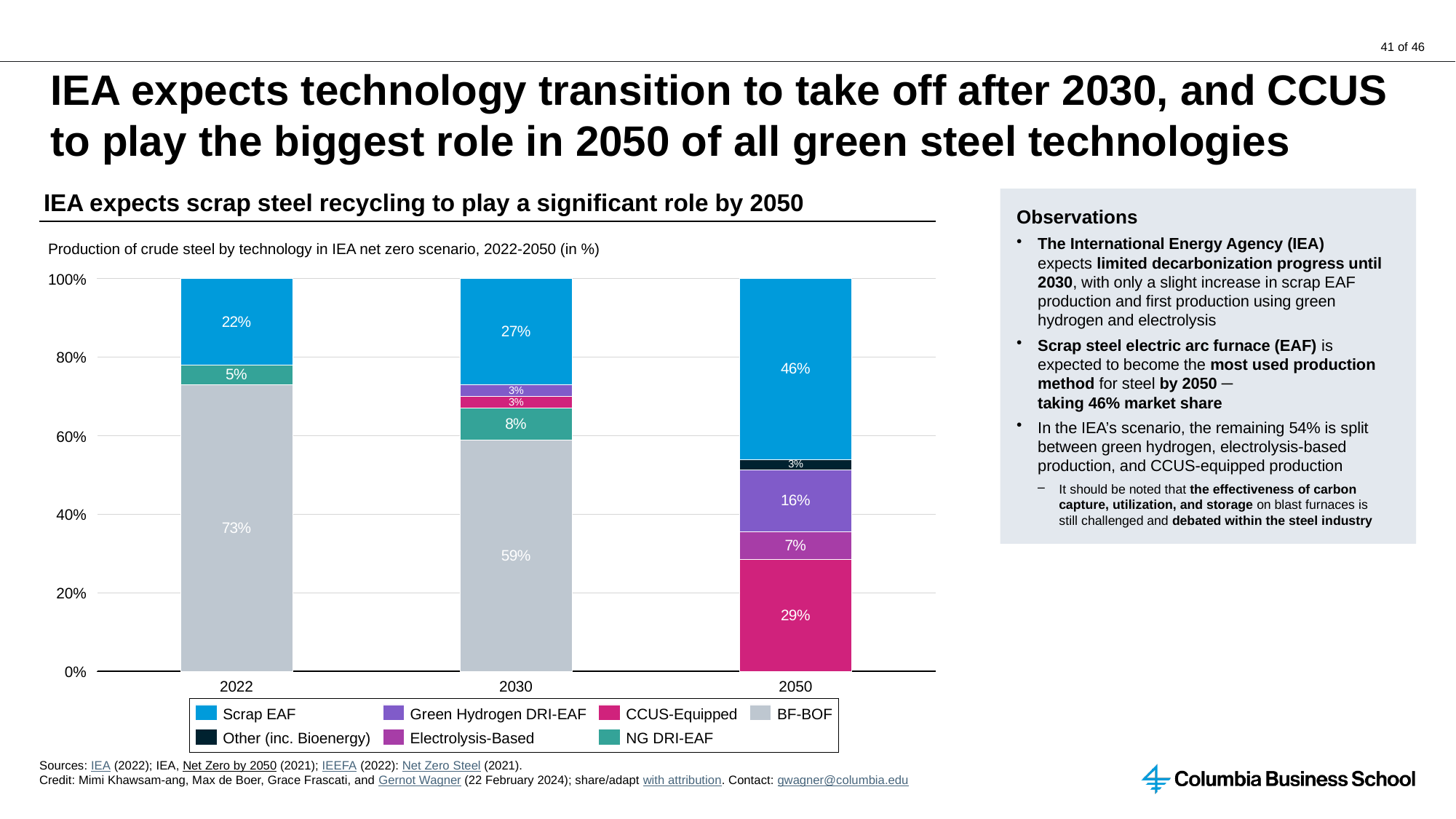
What is the Scrap EAF share in 2050? 46% By how many percentage points does the Scrap EAF share increase from 2022 to 2030? 5 percentage points By how many percentage points does the BF-BOF share fall from 2022 to 2030? 14 percentage points How many technologies does the legend list? 7 What is the NG DRI-EAF share in 2030? 8% What share of crude steel production does BF-BOF account for in 2022? 73% What type of chart is used to show production of crude steel by technology? Stacked bar chart Does the Scrap EAF share rise or fall from 2022 to 2050? Rise What is the CCUS-Equipped share in 2050? 29% How many years are shown on the x axis? 3 What is the Green Hydrogen DRI-EAF share in 2050? 16% In 2050, which is larger: the Green Hydrogen DRI-EAF share or the Electrolysis-Based share? Green Hydrogen DRI-EAF